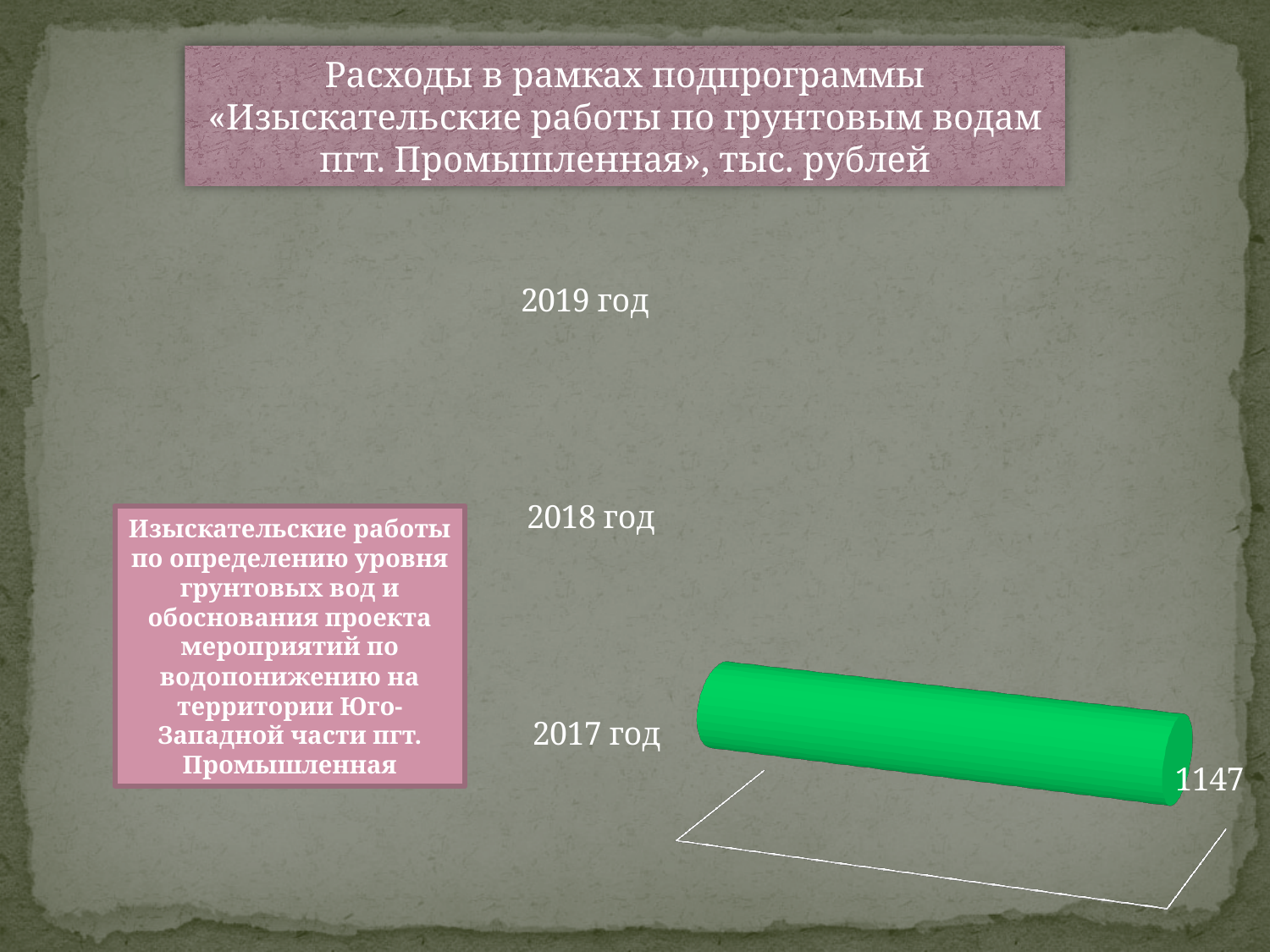
What colour is the bar for 2017 год? green How many year categories are shown on the chart? 3 Is the value for 2017 год greater or less than 1000? greater Which year has the highest value on the chart? 2017 год Which is larger, the value for 2017 год or for 2018 год? 2017 год What kind of chart is shown on the slide? bar chart Which year is the only one with a visible bar on the chart? 2017 год What is the value for 2017 год? 1147